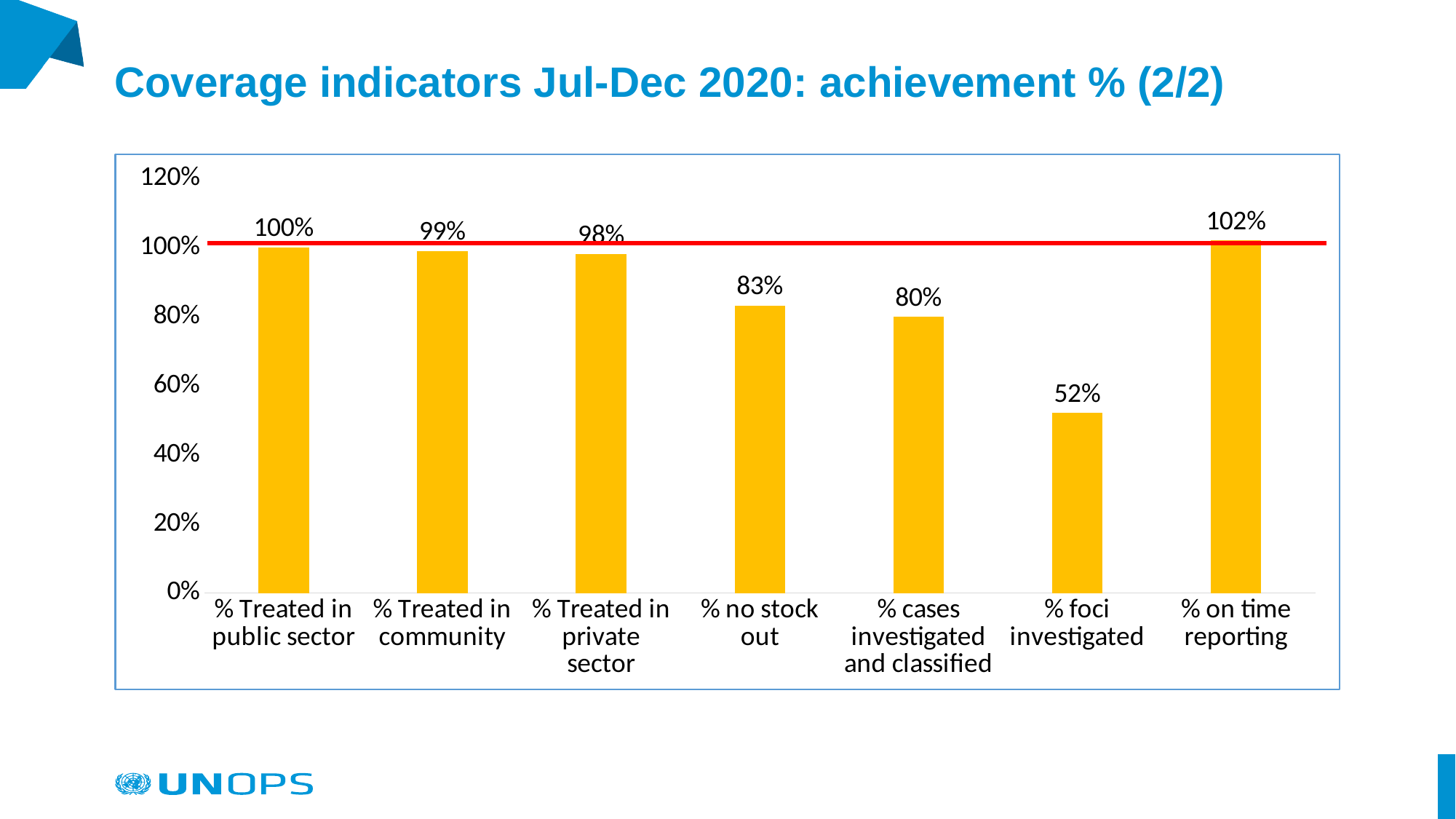
At what value is the red horizontal line drawn across the chart? 100% Which is larger, % no stock out or % cases investigated and classified? % no stock out Which category has the lowest value? % foci investigated What kind of chart is shown on the slide? bar chart What is the value for % Treated in public sector? 100% How many categories are shown in the chart? 7 Is the value for % cases investigated and classified greater or less than 100%? less What is the value for % no stock out? 83% Which category has the highest value? % on time reporting What is the value for % on time reporting? 102% What is the difference between % Treated in public sector and % foci investigated? 48% What is the value for % foci investigated? 52%